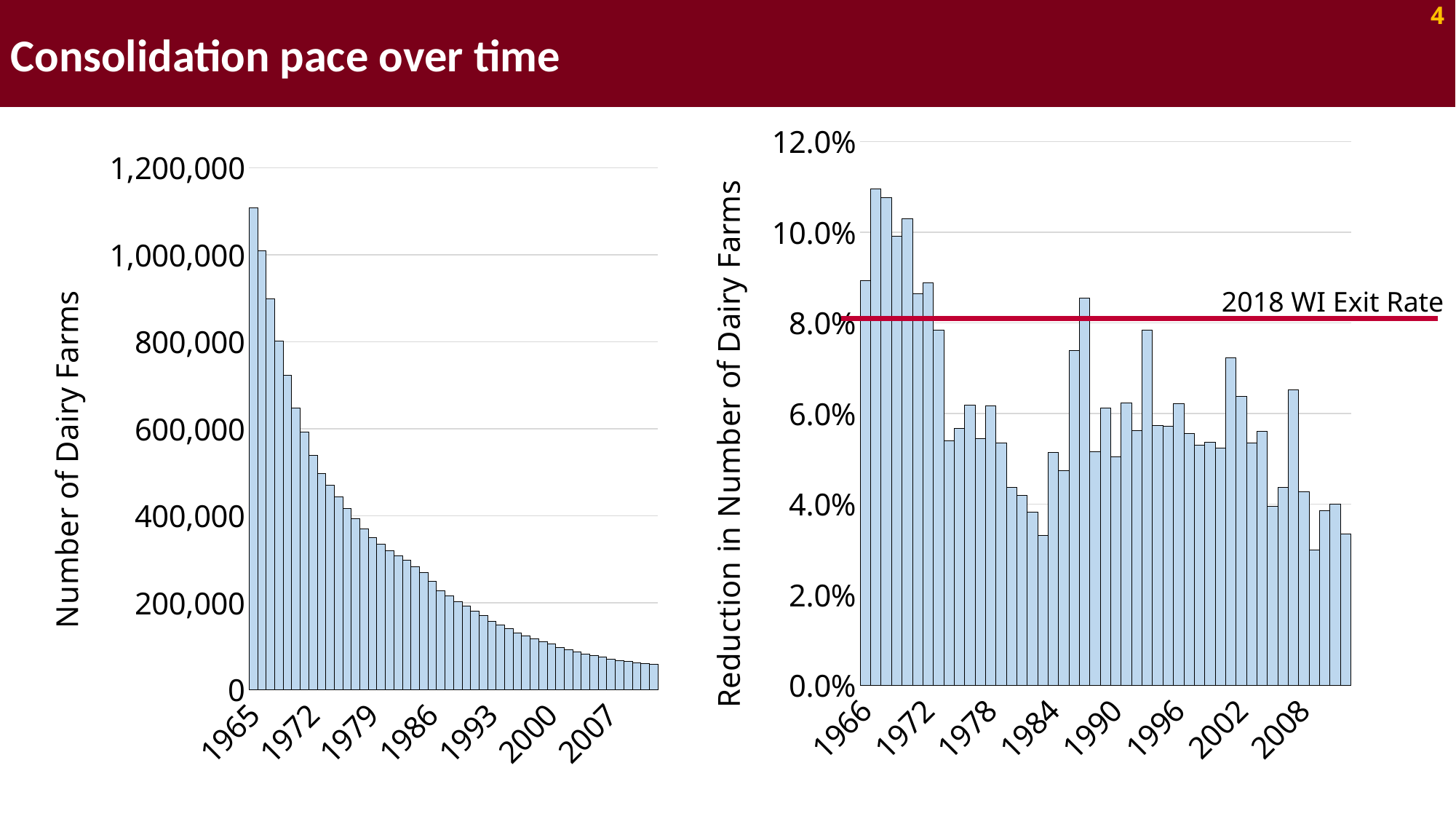
In the right chart (Reduction in Number of Dairy Farms), what does the horizontal red line represent? 2018 WI Exit Rate In the left chart (Number of Dairy Farms), is the value for 1965 greater or less than 1,000,000? greater In the left chart (Number of Dairy Farms), which labelled year has the highest value? 1965 How many charts are shown on the slide? 2 In the right chart (Reduction in Number of Dairy Farms), is the value for 1966 greater or less than 8.0%? greater In the left chart (Number of Dairy Farms), do the values rise or fall from 1965 onward? fall In the left chart (Number of Dairy Farms), is the value for 1965 larger or smaller than the value for 1972? larger What is the y-axis label of the right chart? Reduction in Number of Dairy Farms In the right chart (Reduction in Number of Dairy Farms), is the value for 1984 greater or less than 6.0%? less What kind of chart is the left chart, labelled 'Number of Dairy Farms'? bar chart